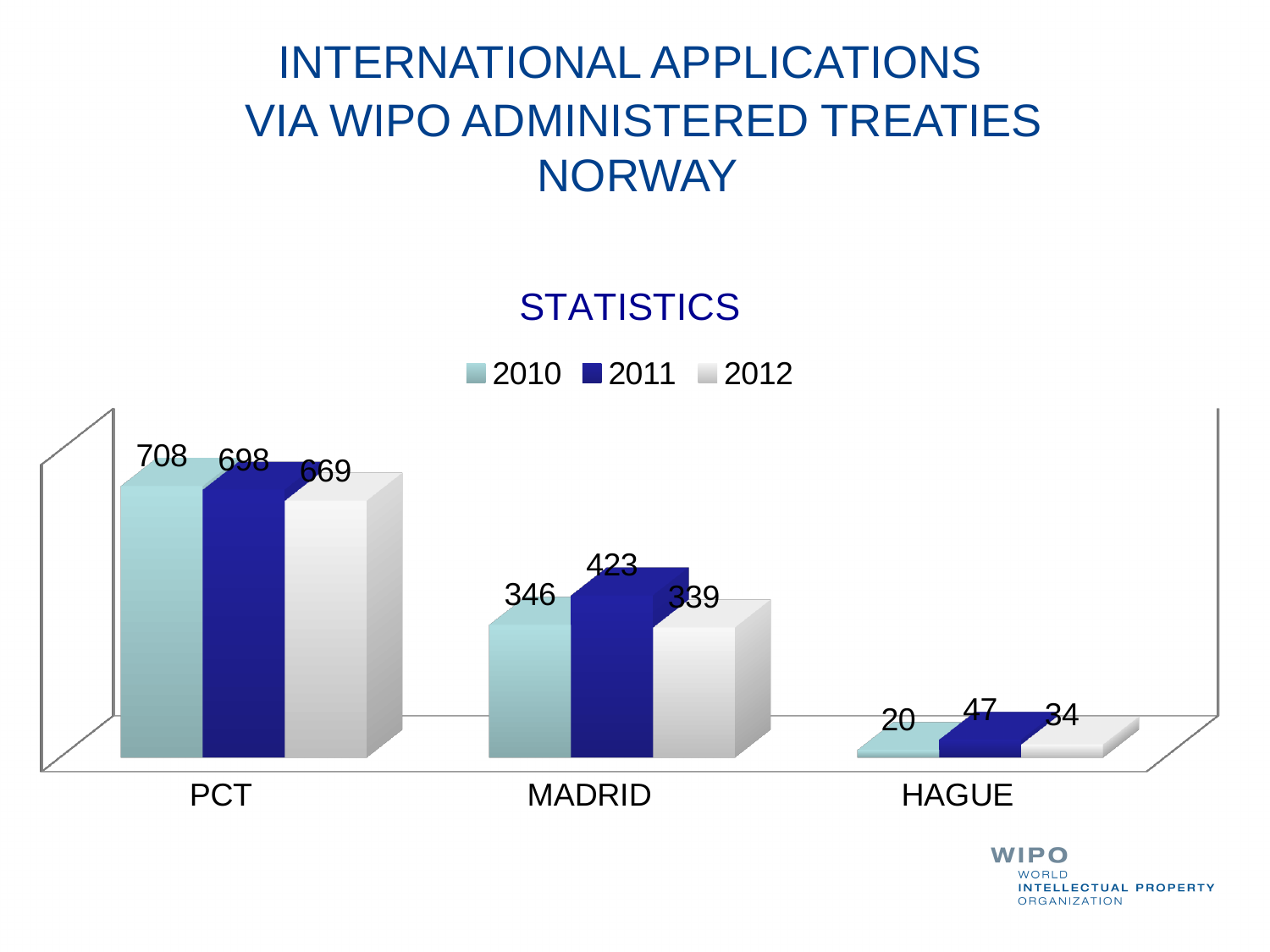
How many series does the legend list? 3 What is the value for MADRID in 2011? 423 What is the value for PCT in 2010? 708 Which is larger, the HAGUE value for 2011 or for 2012? 2011 Which category has the highest value in 2012? PCT How many categories are shown on the x axis? 3 What kind of chart is shown? bar chart Which category has the lowest value in 2010? HAGUE What is the value for HAGUE in 2012? 34 What is the title of the chart? STATISTICS What is the difference between the MADRID values for 2011 and 2012? 84 What is the difference between the PCT values for 2010 and 2012? 39